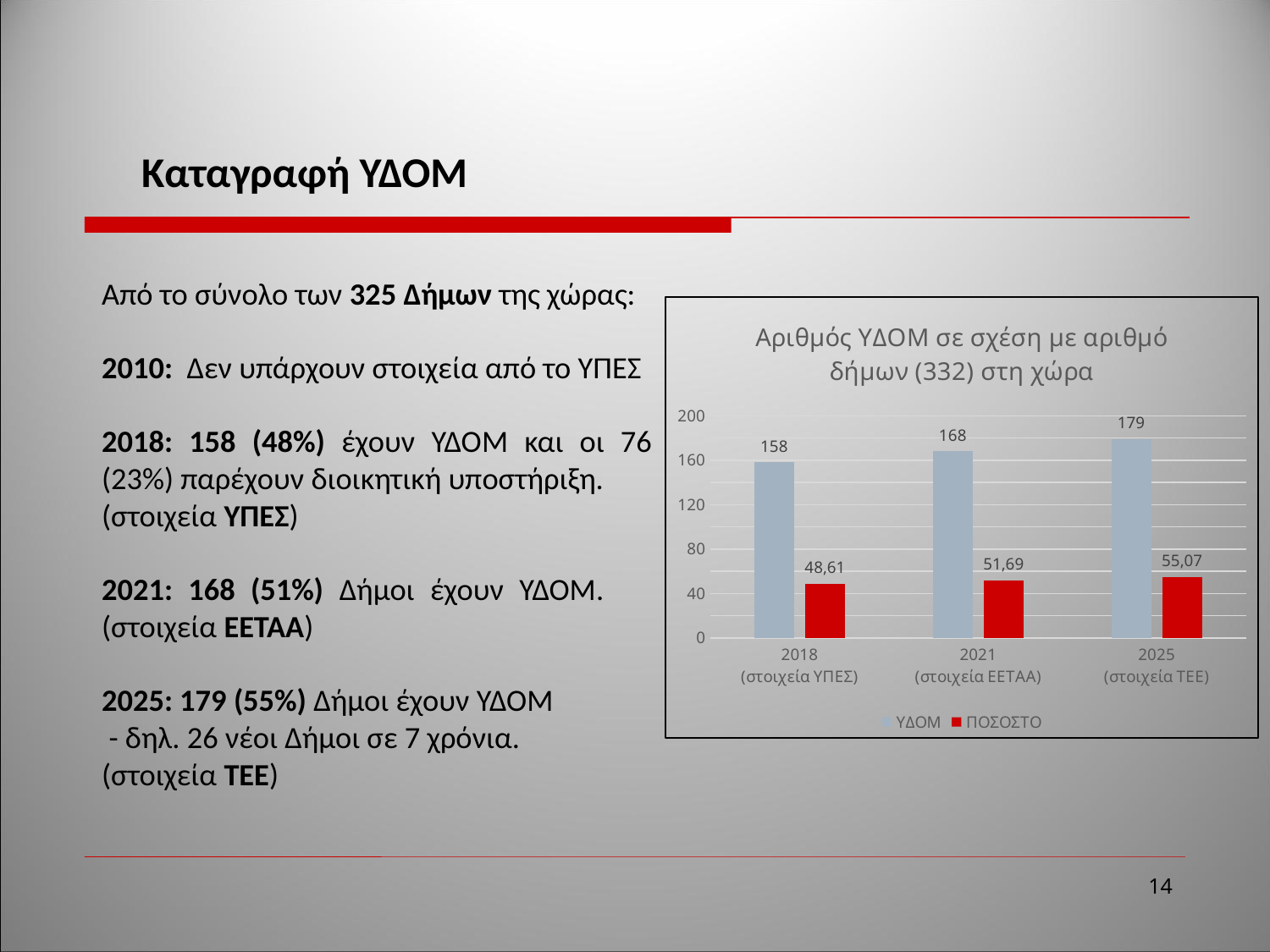
How many categories are shown on the x axis? 3 How many series does the legend list? 2 What is the difference between the ΥΔΟΜ values for 2025 and 2018? 21 What is the ΠΟΣΟΣΤΟ value for 2025 (στοιχεία ΤΕΕ)? 55,07 Which year has the highest ΥΔΟΜ value? 2025 (στοιχεία ΤΕΕ) Is the ΥΔΟΜ value for 2025 greater or less than 160? greater What is the ΥΔΟΜ value for 2021 (στοιχεία ΕΕΤΑΑ)? 168 What type of chart is shown on the slide? Bar chart Do the ΥΔΟΜ values rise or fall from 2018 to 2025? Rise Which year has the lowest ΠΟΣΟΣΤΟ value? 2018 (στοιχεία ΥΠΕΣ) Which is larger, the ΥΔΟΜ value for 2018 or for 2021? 2021 What is the ΠΟΣΟΣΤΟ value for 2018 (στοιχεία ΥΠΕΣ)? 48,61